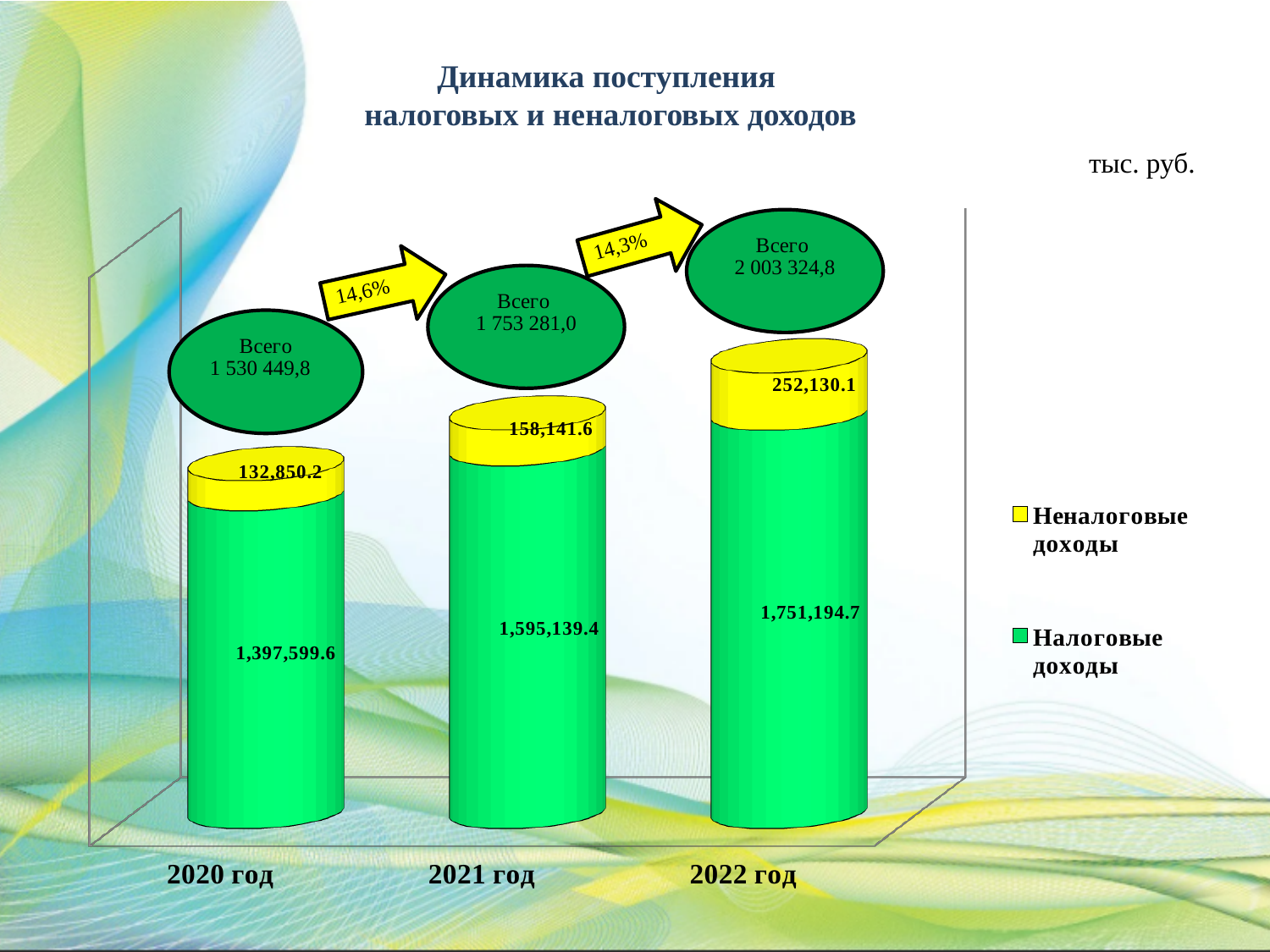
How many series does the legend list? 2 What is the value of Налоговые доходы for 2020 год? 1,397,599.6 Which is larger: Неналоговые доходы in 2021 год or in 2022 год? 2022 год How many years are shown on the x axis? 3 What percentage growth is shown on the arrow between 2020 год and 2021 год? 14,6% What total (Всего) is shown for 2021 год? 1 753 281,0 Which year has the lowest value of Неналоговые доходы? 2020 год What is the difference between Налоговые доходы in 2022 год and 2021 год? 156,055.3 What kind of chart is shown on the slide? Stacked bar chart What is the value of Неналоговые доходы for 2022 год? 252,130.1 What is the value of Неналоговые доходы for 2021 год? 158,141.6 Which year has the highest value of Налоговые доходы? 2022 год